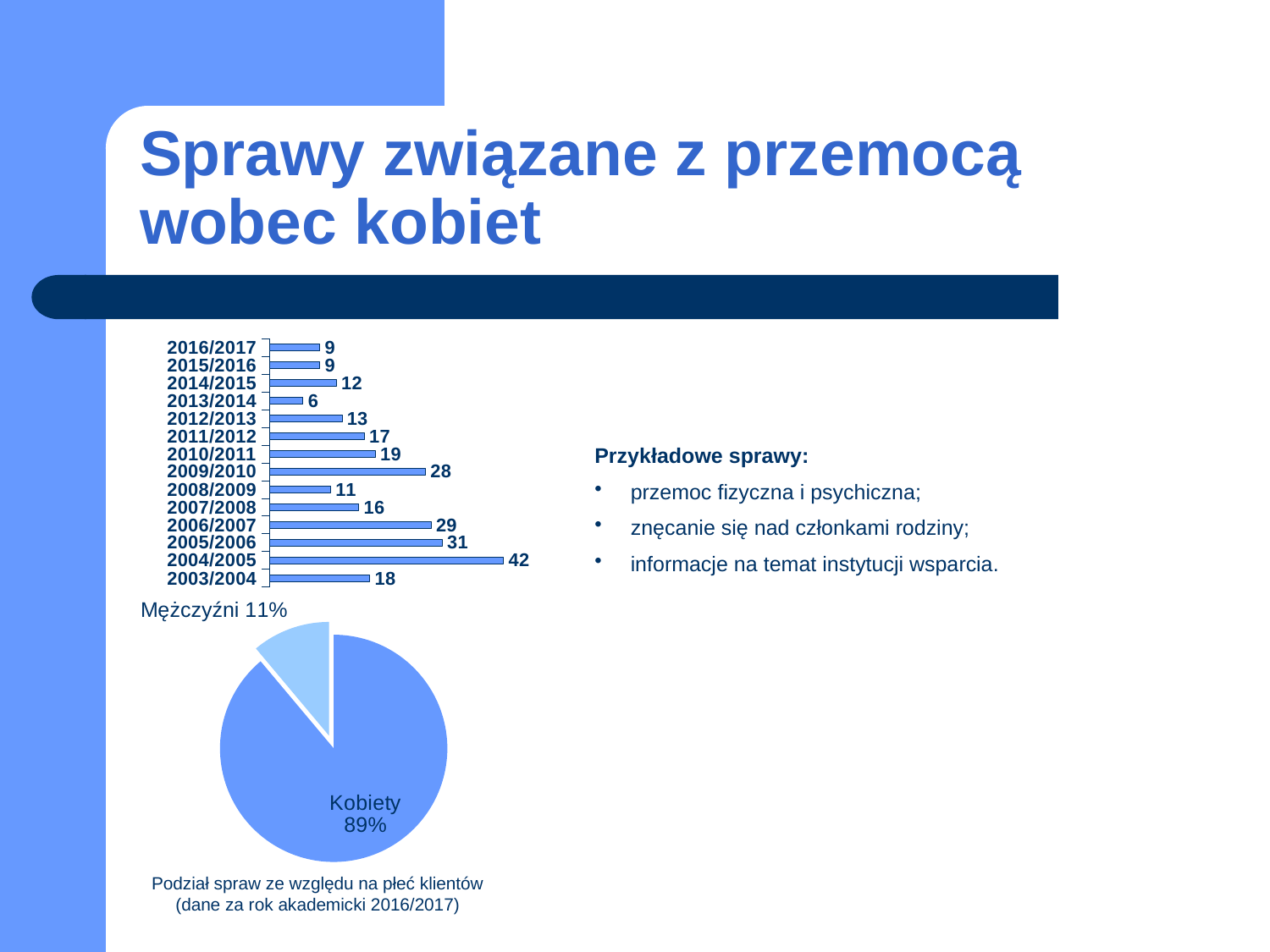
In the pie chart at the bottom of the slide, what share is labelled Kobiety? 89% How many slices does the pie chart at the bottom of the slide have? 2 In the bar chart at the top of the slide, what is the value for 2004/2005? 42 In the bar chart at the top of the slide, which is larger, the value for 2009/2010 or the value for 2010/2011? 2009/2010 In the bar chart at the top of the slide, what is the value for 2016/2017? 9 In the bar chart at the top of the slide, which academic year has the highest value? 2004/2005 In the pie chart at the bottom of the slide, what share is labelled Mężczyźni? 11% In the bar chart at the top of the slide, which academic year has the lowest value? 2013/2014 What is the caption under the pie chart at the bottom of the slide? Podział spraw ze względu na płeć klientów (dane za rok akademicki 2016/2017) How many academic years are shown in the bar chart at the top of the slide? 14 In the bar chart at the top of the slide, what is the difference between the values for 2005/2006 and 2006/2007? 2 What kind of chart is the chart at the top of the slide? bar chart